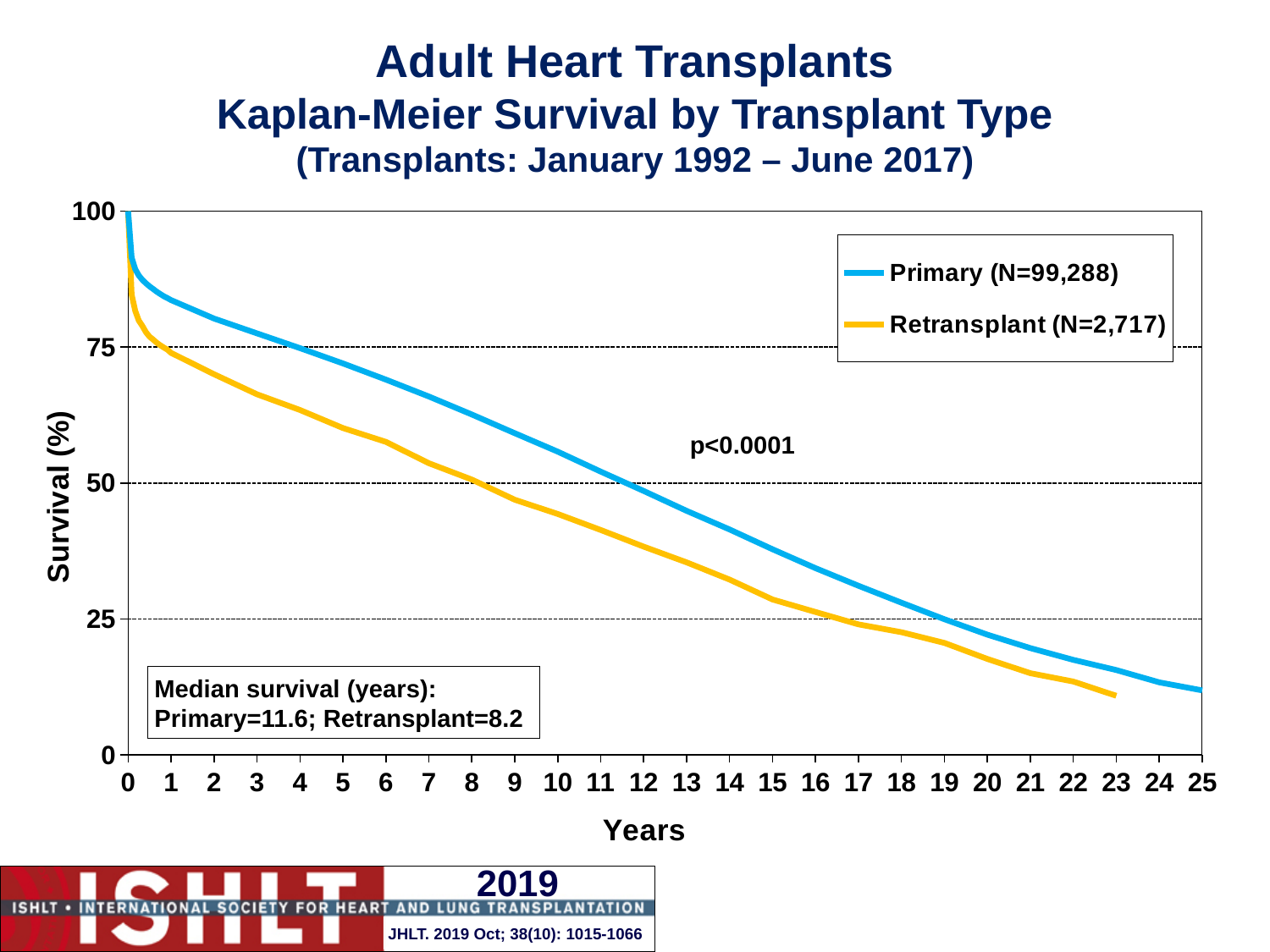
How many series does the legend list? 2 What kind of chart is shown on the slide? line chart Do the survival curves rise or fall as years increase? fall What is the difference in median survival (years) between Primary and Retransplant? 3.4 Is the survival for Primary at 20 years greater or less than 25? less What is the median survival in years for Retransplant? 8.2 Which transplant type has the longer median survival? Primary What p-value is printed on the chart? p<0.0001 Which series has the higher survival at 10 years, Primary or Retransplant? Primary What is the median survival in years for Primary transplants? 11.6 Is the survival for Primary at 10 years greater or less than 50? greater Is the survival for Retransplant at 10 years greater or less than 50? less